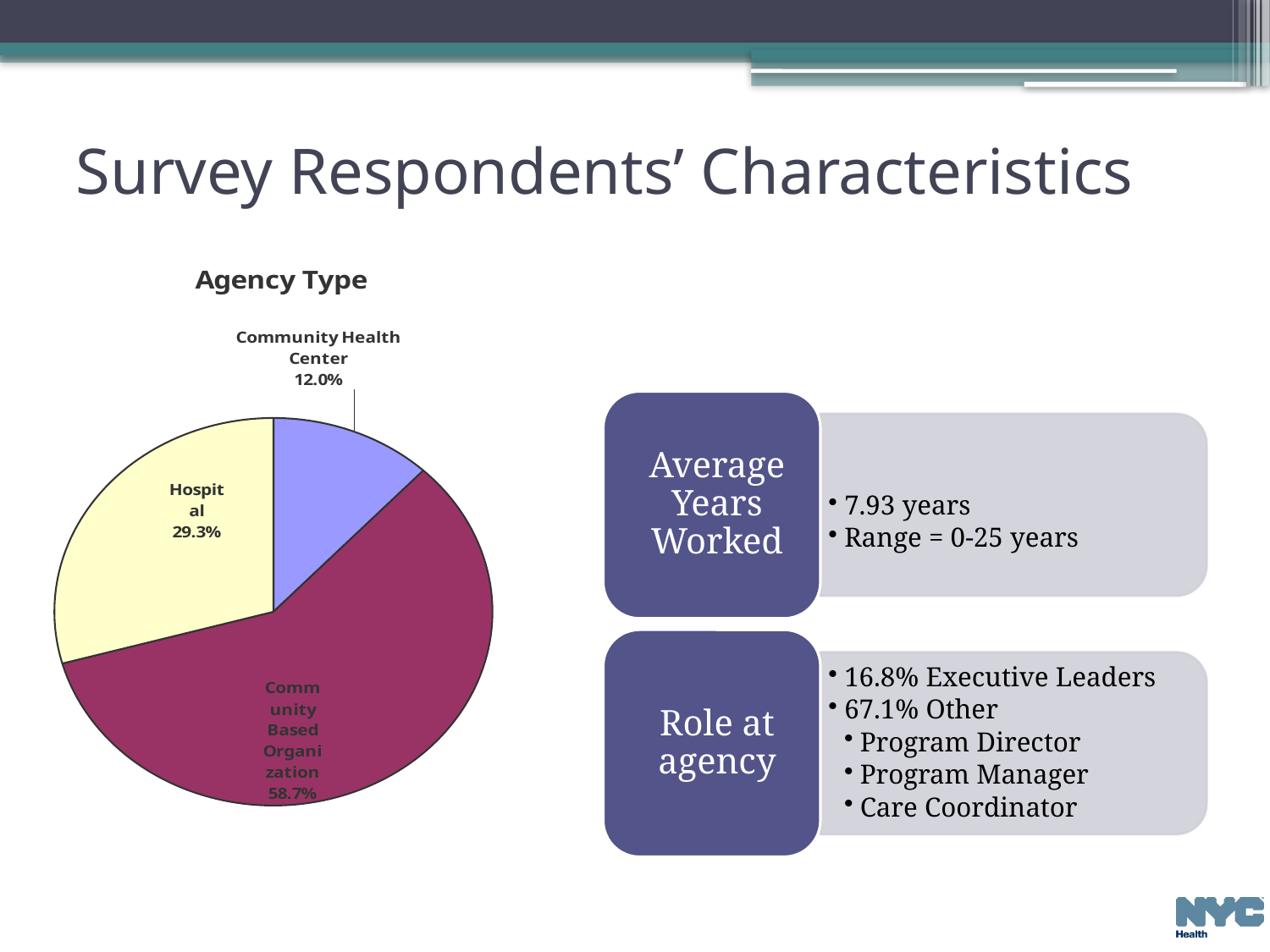
Which is larger, the Hospital slice or the Community Health Center slice? Hospital What is the title of the chart on the slide? Agency Type How many slices does the Agency Type pie chart have? 3 What percentage of respondents are from a Hospital? 29.3% Which agency type has the largest share of the pie? Community Based Organization What colour is the Community Based Organization slice in the pie chart? magenta/purple Which agency type has the smallest share of the pie? Community Health Center What percentage of respondents are from a Community Health Center? 12.0% What percentage of respondents are from a Community Based Organization? 58.7% What is the difference in percentage points between the Hospital and Community Health Center slices? 17.3 What type of chart is shown under the title "Agency Type"? pie chart What is the difference in percentage points between the Community Based Organization and Hospital slices? 29.4